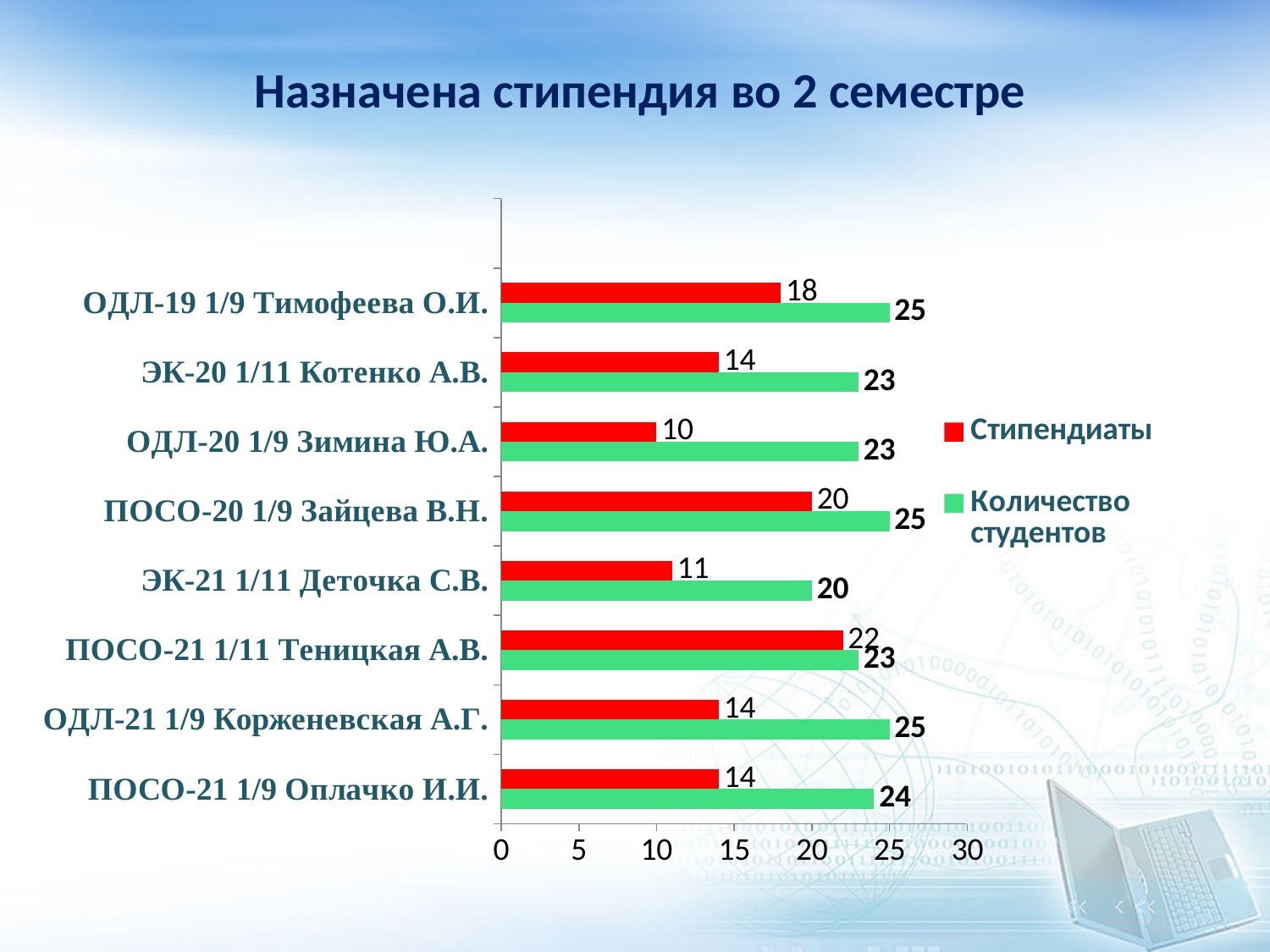
How many categories are shown on the chart? 8 Which category has the lowest value for Количество студентов? ЭК-21 1/11 Деточка С.В. What is the value of Стипендиаты for ОДЛ-19 1/9 Тимофеева О.И.? 18 Is the value of Стипендиаты for ЭК-21 1/11 Деточка С.В. greater or less than 15? less What is the value of Количество студентов for ЭК-21 1/11 Деточка С.В.? 20 What is the difference between Количество студентов and Стипендиаты for ОДЛ-20 1/9 Зимина Ю.А.? 13 Which category has the lowest value for Стипендиаты? ОДЛ-20 1/9 Зимина Ю.А. What is the title of the chart? Назначена стипендия во 2 семестре Which category has the highest value for Стипендиаты? ПОСО-21 1/11 Теницкая А.В. What kind of chart is shown on the slide? bar chart How many series does the legend list? 2 Which is larger: Стипендиаты for ПОСО-20 1/9 Зайцева В.Н. or Стипендиаты for ЭК-20 1/11 Котенко А.В.? ПОСО-20 1/9 Зайцева В.Н.